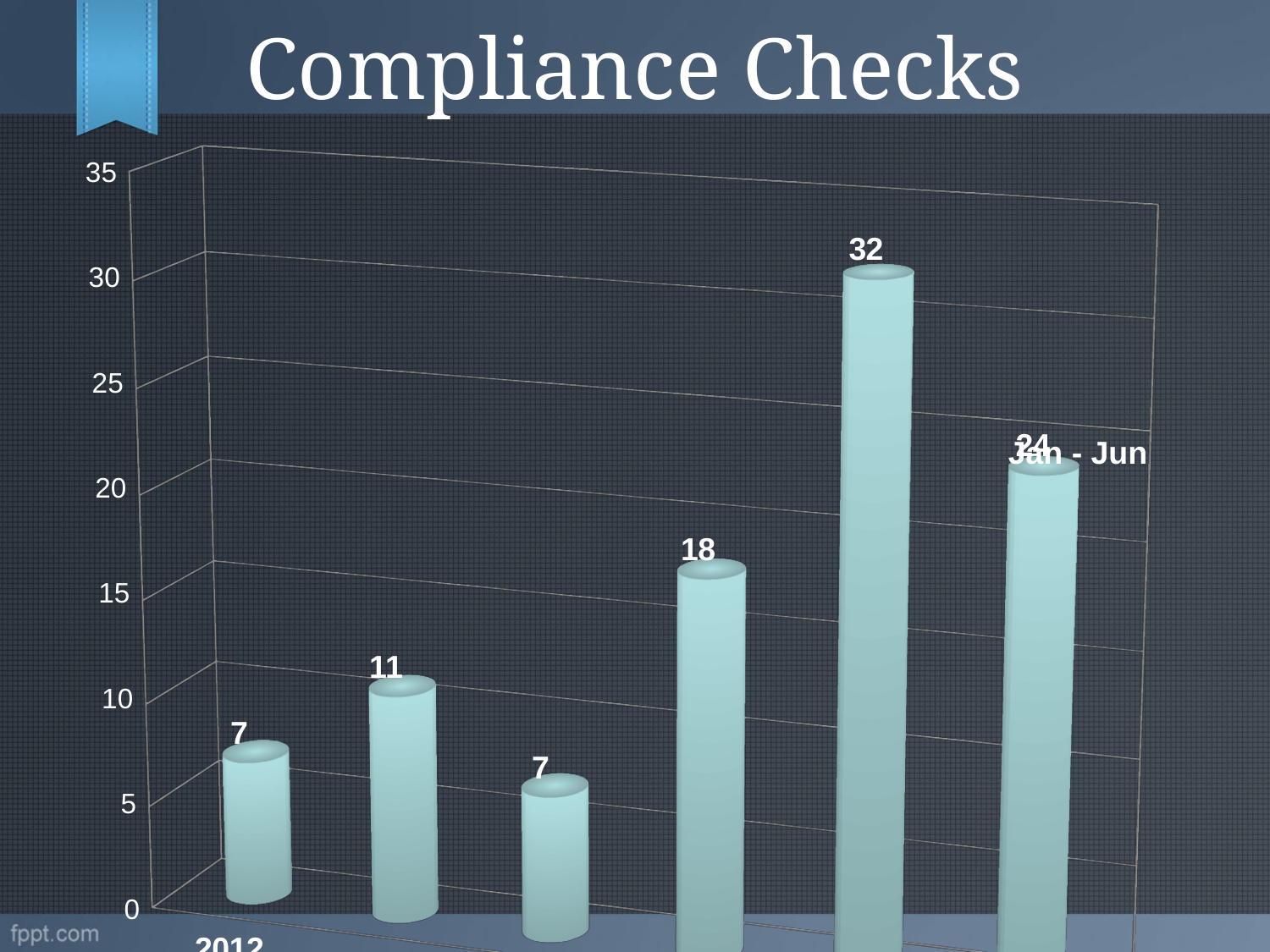
What is the difference between the highest bar value and the lowest bar value in the chart? 25 What kind of chart is shown on the slide? bar chart What is the value of the last bar on the right, labelled Jan - Jun? 24 What is the difference between the tallest bar (32) and the last bar on the right (24)? 8 Which is larger: the second bar from the left or the fourth bar from the left? the fourth bar What is the value of the first bar from the left? 7 What is the value of the fourth bar from the left? 18 How many bars are plotted in the chart? 6 What is the title of the chart? Compliance Checks What is the lowest value shown by any bar in the chart? 7 Is the value of the fifth bar from the left greater or less than 30? greater What is the highest value shown by any bar in the chart? 32